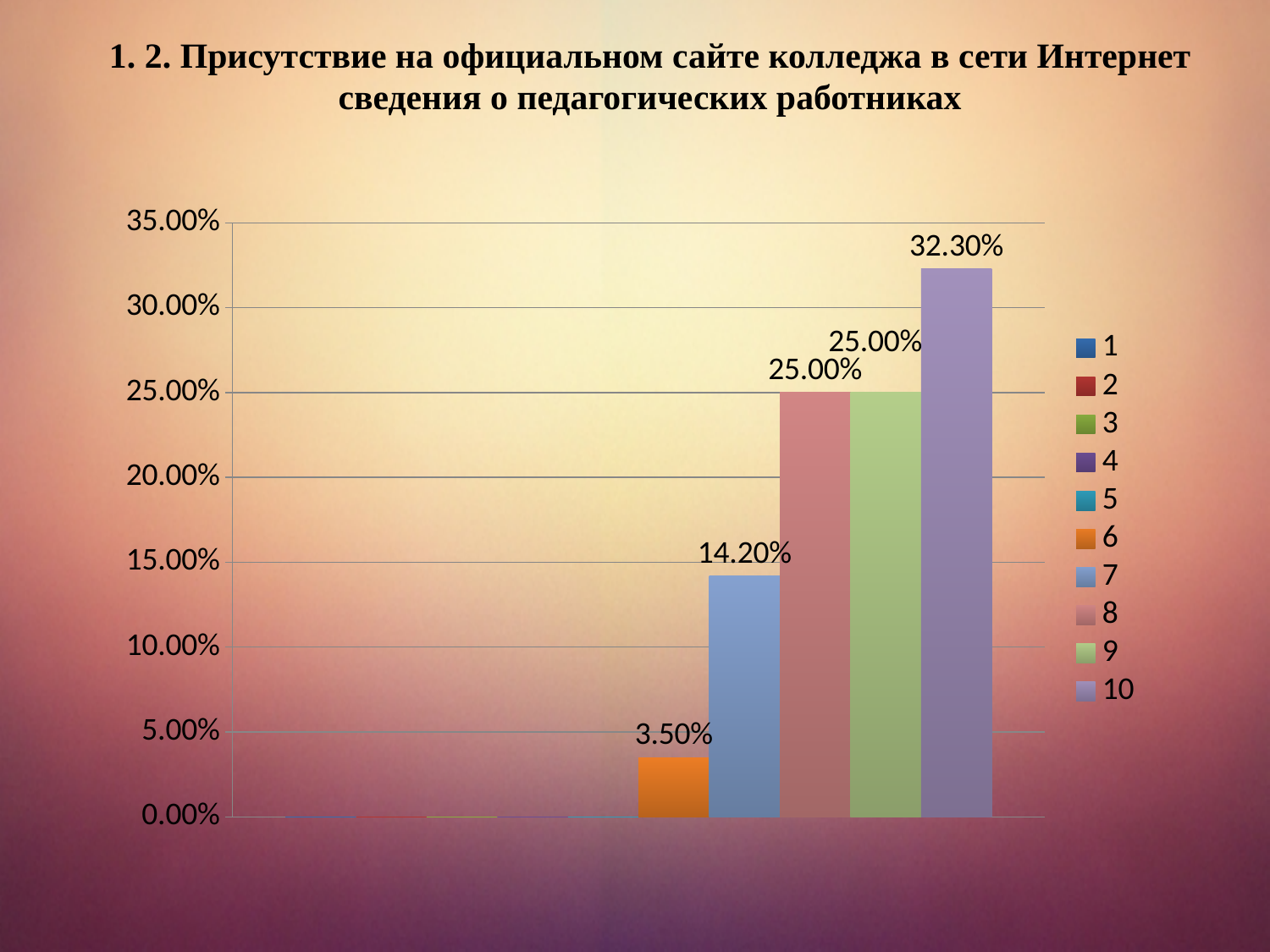
What kind of chart is shown on the slide? bar chart Is the value for series 10 greater or less than 30.00%? greater Which series has the highest value? 10 What is the value for series 7? 14.20% How many series does the legend list? 10 Which of the series with a visible bar has the lowest value? 6 Which is larger, the value for series 7 or the value for series 9? series 9 What colour is the bar for series 6? orange What is the value for series 8? 25.00% What is the value for series 6? 3.50% What is the difference between the values for series 10 and series 7? 18.10% What is the value for series 10? 32.30%